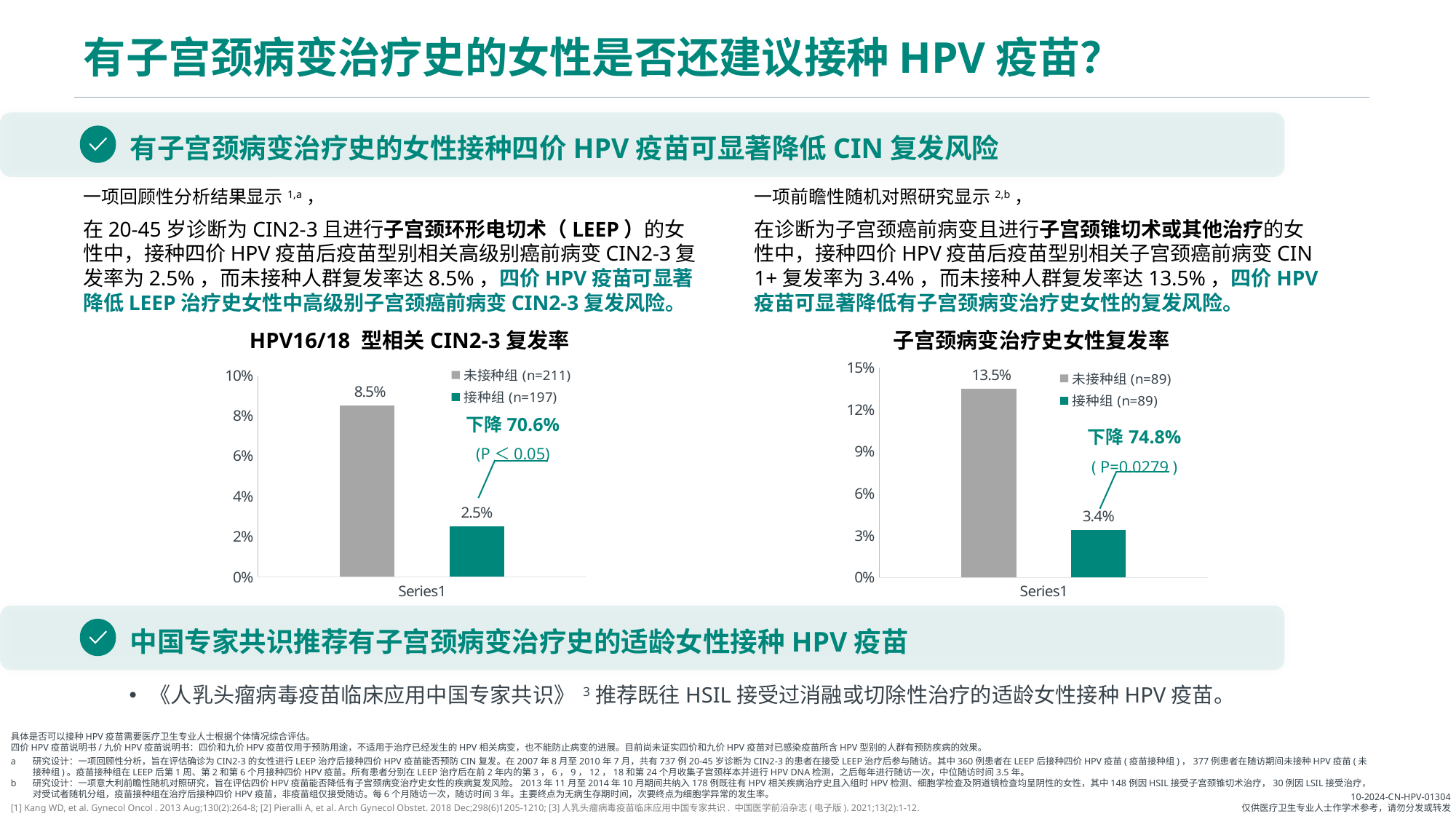
What type of chart is the chart titled "子宫颈病变治疗史女性复发率"? bar chart In the chart titled "HPV16/18 型相关 CIN2-3 复发率", what is the value for 未接种组 (n=211)? 8.5% In the chart titled "子宫颈病变治疗史女性复发率", what is the difference between the 未接种组 and 接种组 values? 10.1% In the chart titled "HPV16/18 型相关 CIN2-3 复发率", what colour is the bar for 接种组 (n=197)? green In the chart titled "子宫颈病变治疗史女性复发率", which group has the lower recurrence rate? 接种组 (n=89) In the chart titled "HPV16/18 型相关 CIN2-3 复发率", what is the value for 接种组 (n=197)? 2.5% In the chart titled "子宫颈病变治疗史女性复发率", what is the value for 接种组 (n=89)? 3.4% In the chart titled "HPV16/18 型相关 CIN2-3 复发率", what is the difference between the 未接种组 and 接种组 values? 6.0% How many series does the legend list in the chart titled "HPV16/18 型相关 CIN2-3 复发率"? 2 In the chart titled "子宫颈病变治疗史女性复发率", what is the value for 未接种组 (n=89)? 13.5% In the chart titled "子宫颈病变治疗史女性复发率", is the value for 未接种组 (n=89) greater or less than 12%? greater In the chart titled "HPV16/18 型相关 CIN2-3 复发率", which group has the higher recurrence rate? 未接种组 (n=211)